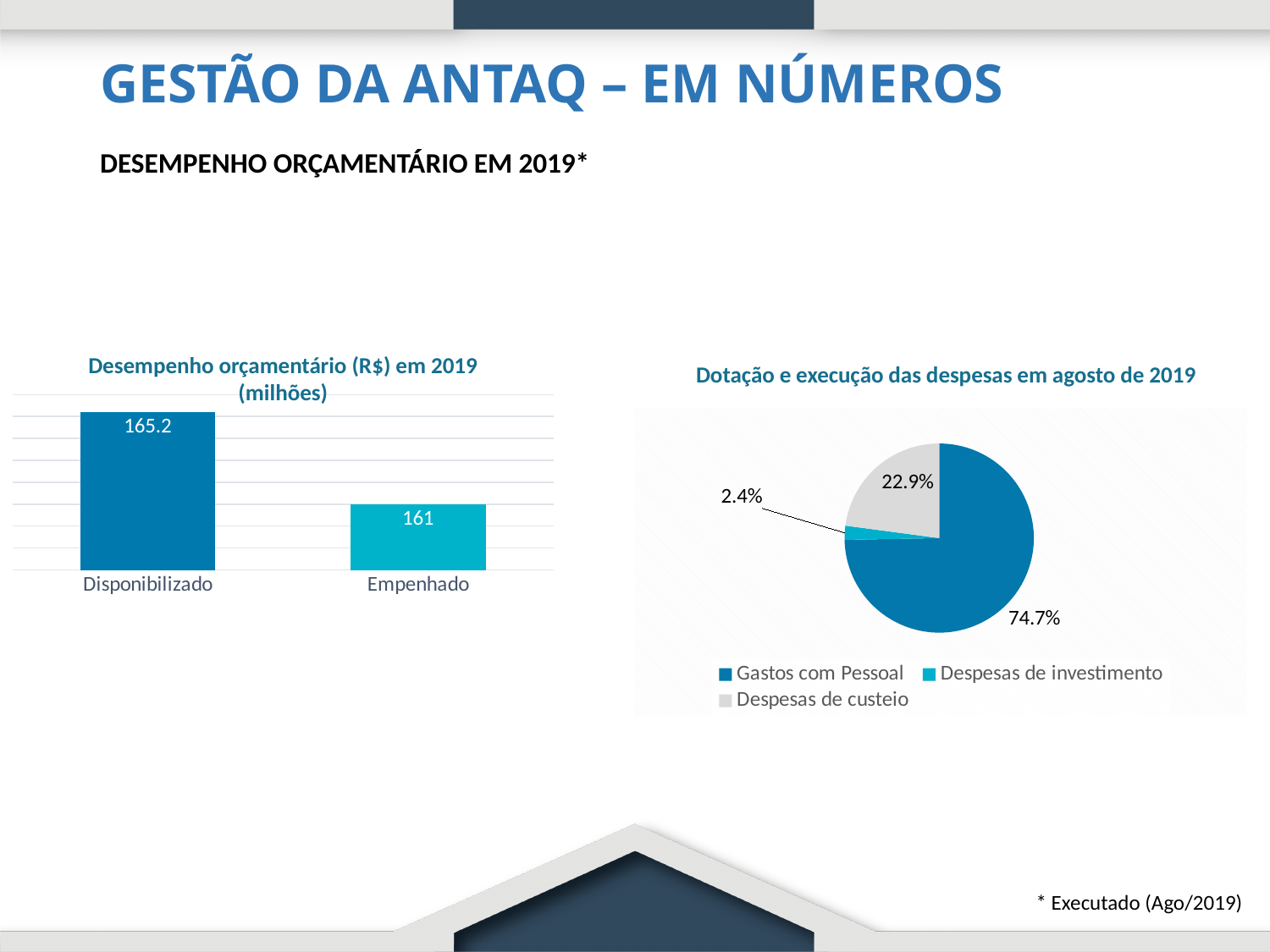
In the 'Dotação e execução das despesas em agosto de 2019' chart, which category has the smallest slice? Despesas de investimento In the 'Desempenho orçamentário (R$) em 2019 (milhões)' chart, what is the value for Empenhado? 161 What kind of chart is 'Dotação e execução das despesas em agosto de 2019'? Pie chart In the 'Desempenho orçamentário (R$) em 2019 (milhões)' chart, what is the value for Disponibilizado? 165.2 In the 'Desempenho orçamentário (R$) em 2019 (milhões)' chart, how many categories are shown? 2 In the 'Desempenho orçamentário (R$) em 2019 (milhões)' chart, what is the difference between Disponibilizado and Empenhado? 4.2 How many entries does the legend of the 'Dotação e execução das despesas em agosto de 2019' chart list? 3 In the 'Desempenho orçamentário (R$) em 2019 (milhões)' chart, which category has the higher value? Disponibilizado In the 'Dotação e execução das despesas em agosto de 2019' chart, what share is Despesas de investimento? 2.4% In the 'Dotação e execução das despesas em agosto de 2019' chart, what share is Despesas de custeio? 22.9% In the 'Dotação e execução das despesas em agosto de 2019' chart, what share is Gastos com Pessoal? 74.7% What kind of chart is 'Desempenho orçamentário (R$) em 2019 (milhões)'? Bar chart